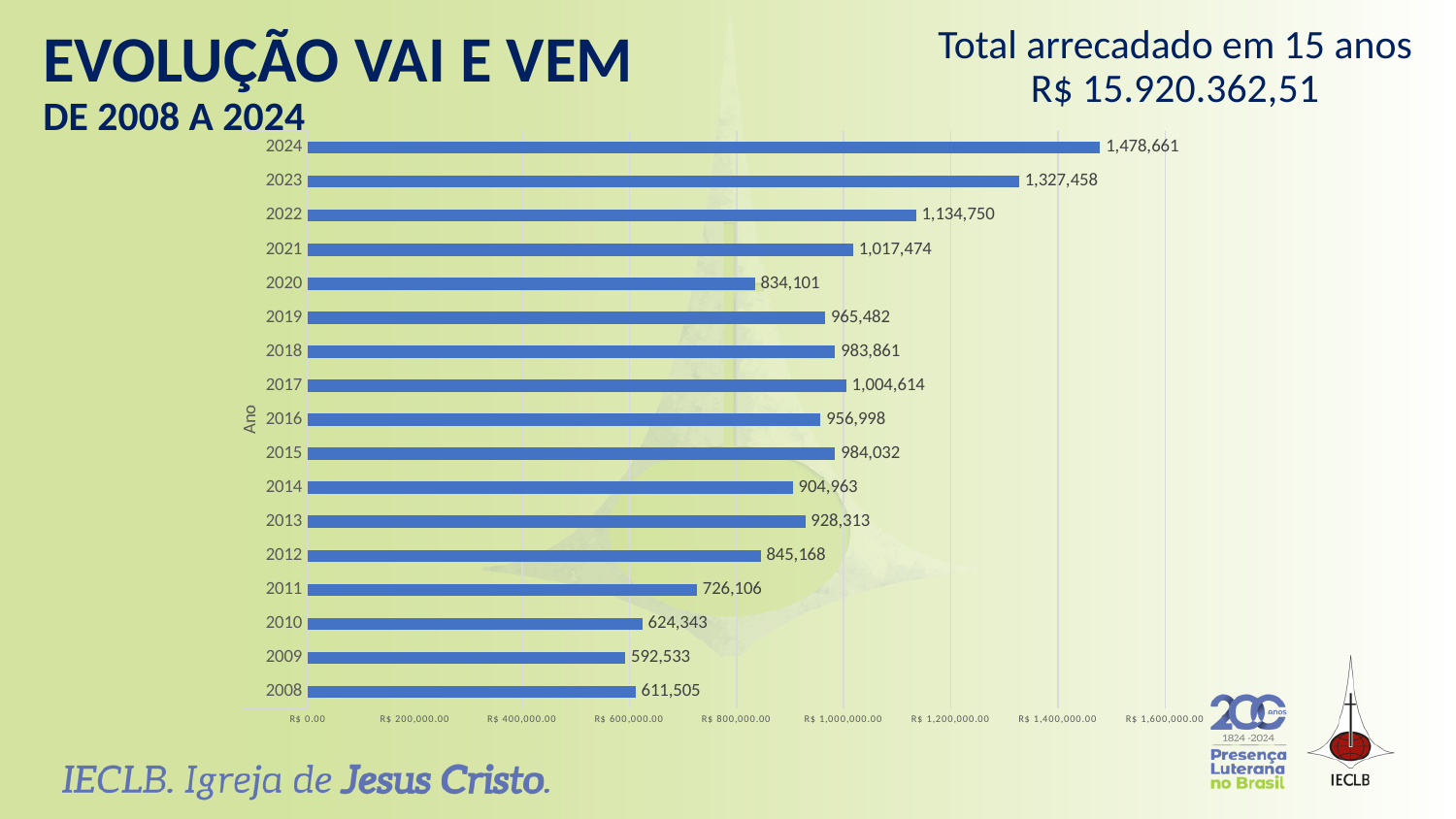
What is the value for 2013? 928,313 Which year has the highest value? 2024 What kind of chart is shown on the slide? bar chart Which year has the lowest value? 2009 Is the value for 2022 greater or less than R$ 1,000,000.00? greater What is the label of the vertical axis? Ano Which is larger, the value for 2008 or the value for 2009? 2008 What is the difference between the values for 2024 and 2023? 151,203 What is the value for 2020? 834,101 How many years are shown in the chart? 17 What is the value for 2024? 1,478,661 Do the values rise or fall from 2020 to 2024? rise